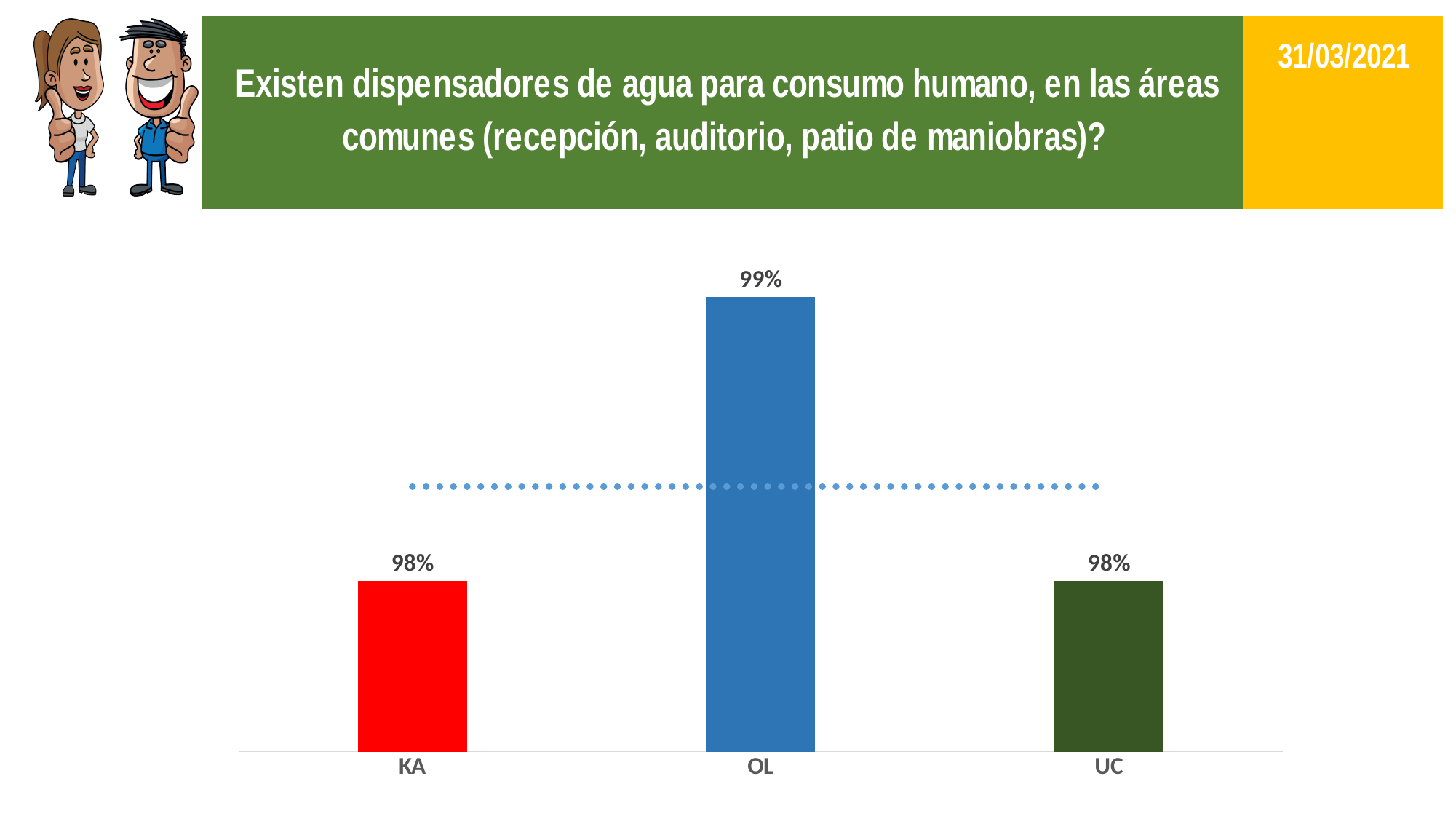
What is the value for KA? 98% How many categories are shown on the x axis? 3 Which category has the highest value? OL What kind of chart is shown on the slide? bar chart What colour is the bar for OL? blue What is the value for UC? 98% What colour is the bar for KA? red What is the value for OL? 99% What is the difference between the values for OL and KA? 1% Which is larger, the value for OL or the value for UC? OL